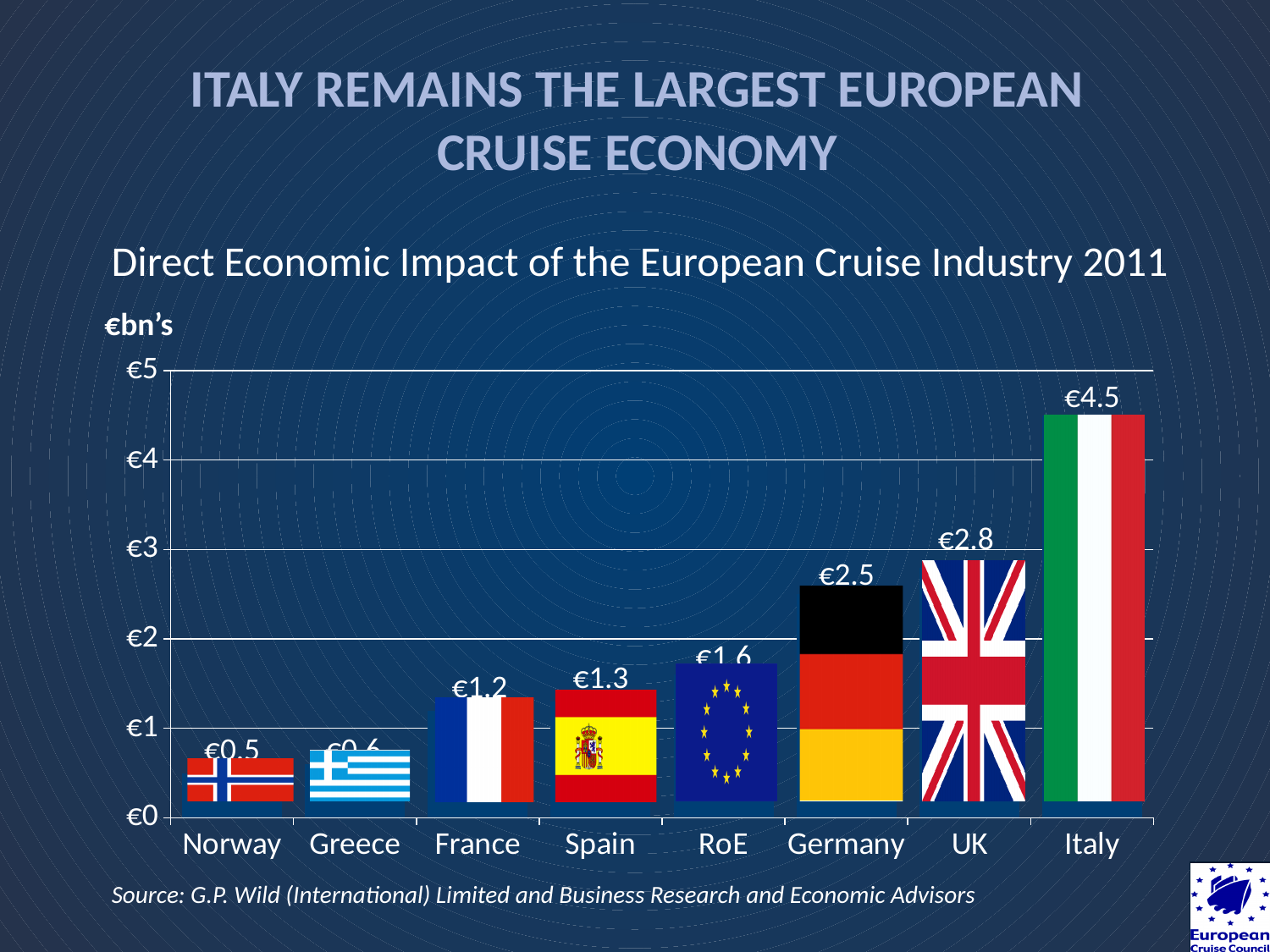
How many categories are shown on the x axis? 8 What unit is shown above the vertical axis? €bn's What is the difference between the values for Italy and the UK? €1.7 Which is larger, the value for Germany or the value for France? Germany What is the value for Italy? €4.5 What kind of chart is shown on the slide? Bar chart What is the value for Norway? €0.5 What is the value for the UK? €2.8 Is the value for Greece greater or less than €1? less Which category has the lowest value? Norway Which country has the highest direct economic impact? Italy What is the value for Germany? €2.5